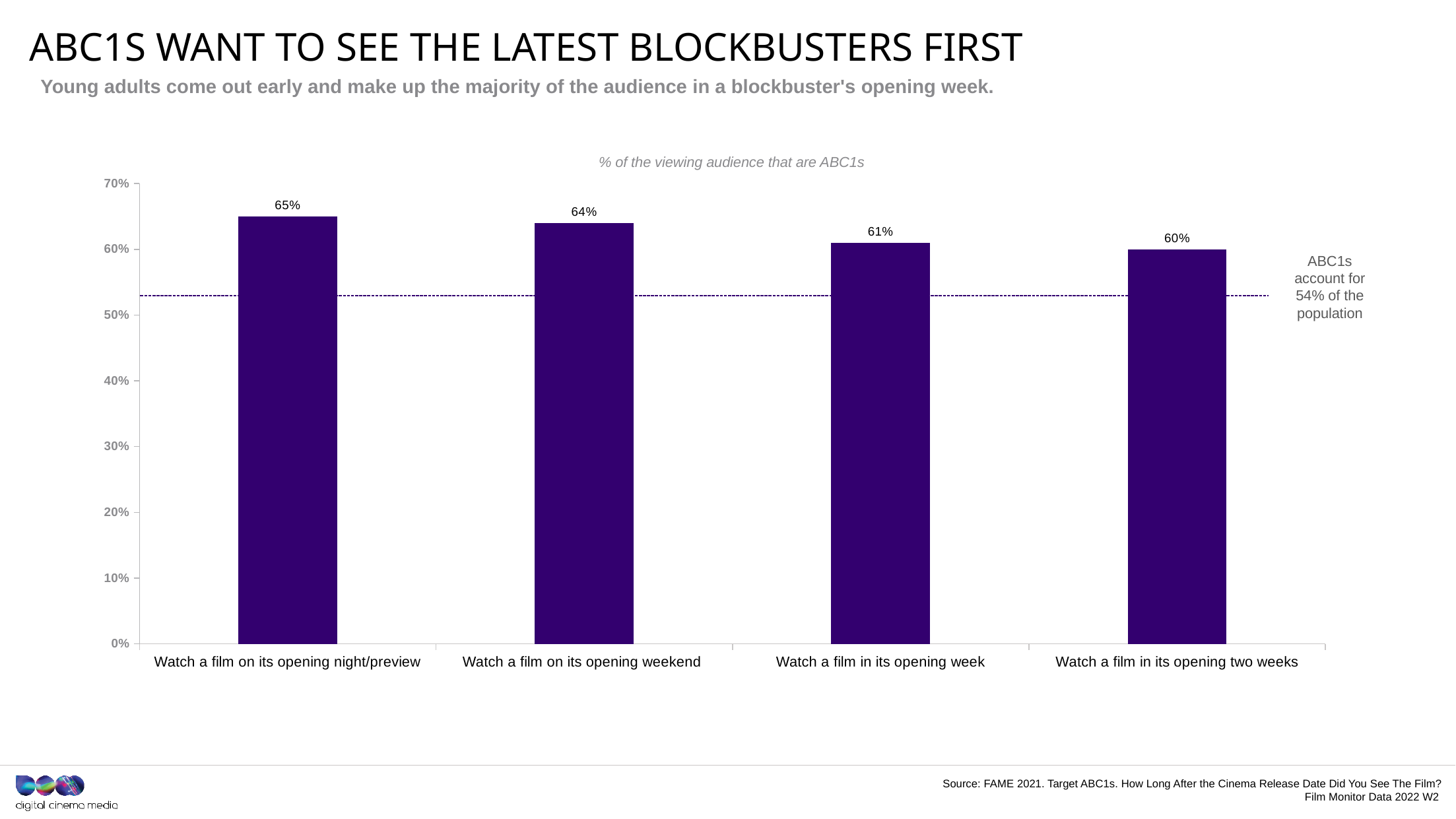
What is the difference between the values for 'Watch a film on its opening night/preview' and 'Watch a film in its opening two weeks'? 5% How many categories are shown on the chart? 4 What percentage of the viewing audience are ABC1s for 'Watch a film on its opening night/preview'? 65% Which category has the highest share of ABC1s? Watch a film on its opening night/preview What is the value for 'Watch a film on its opening weekend'? 64% What kind of chart is shown on the slide? Bar chart What is the value for 'Watch a film in its opening two weeks'? 60% Do the values rise or fall from left to right across the categories? Fall Which is larger: the value for 'Watch a film on its opening weekend' or 'Watch a film in its opening week'? Watch a film on its opening weekend What is the value for 'Watch a film in its opening week'? 61% Which category has the lowest share of ABC1s? Watch a film in its opening two weeks According to the dotted reference line annotation, what share of the population do ABC1s account for? 54%